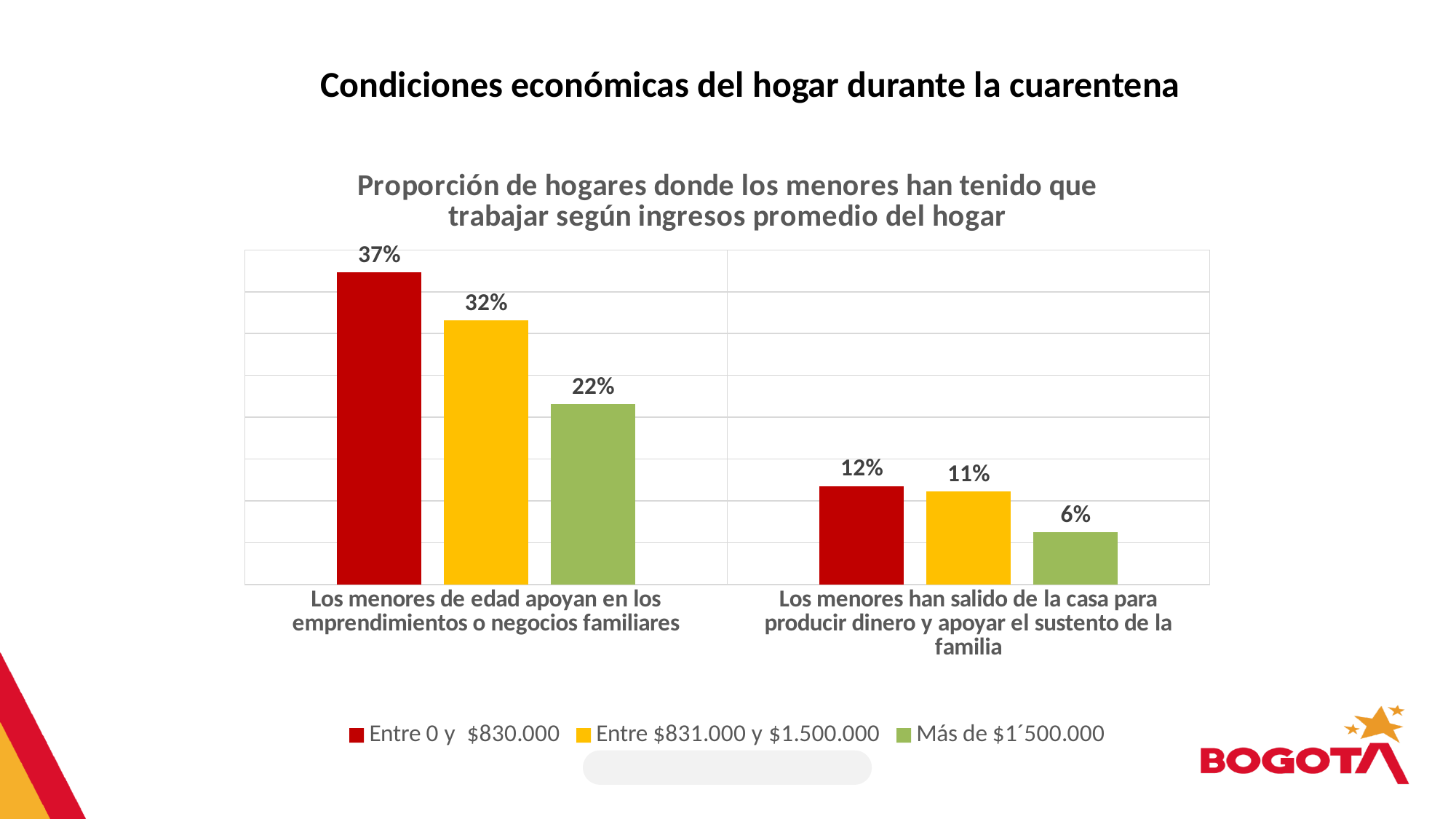
What is the value for 'Entre 0 y $830.000' in the category 'Los menores de edad apoyan en los emprendimientos o negocios familiares'? 37% What is the value for 'Más de $1´500.000' in the category 'Los menores han salido de la casa para producir dinero y apoyar el sustento de la familia'? 6% What is the difference between the 'Entre 0 y $830.000' and 'Más de $1´500.000' values in the category 'Los menores de edad apoyan en los emprendimientos o negocios familiares'? 15% How many series does the legend list? 3 Which income group has the highest value in the category 'Los menores de edad apoyan en los emprendimientos o negocios familiares'? Entre 0 y $830.000 What is the difference between the 'Entre $831.000 y $1.500.000' and 'Más de $1´500.000' values in the category 'Los menores han salido de la casa para producir dinero y apoyar el sustento de la familia'? 5% What kind of chart is shown on the slide? Bar chart What is the title of the chart? Proporción de hogares donde los menores han tenido que trabajar según ingresos promedio del hogar What is the value for 'Entre $831.000 y $1.500.000' in the category 'Los menores de edad apoyan en los emprendimientos o negocios familiares'? 32% Which is larger: the 'Entre $831.000 y $1.500.000' value for 'Los menores de edad apoyan en los emprendimientos o negocios familiares' or the 'Entre 0 y $830.000' value for 'Los menores han salido de la casa para producir dinero y apoyar el sustento de la familia'? Entre $831.000 y $1.500.000 for 'Los menores de edad apoyan en los emprendimientos o negocios familiares' Which income group has the lowest value in the category 'Los menores han salido de la casa para producir dinero y apoyar el sustento de la familia'? Más de $1´500.000 What is the value for 'Entre 0 y $830.000' in the category 'Los menores han salido de la casa para producir dinero y apoyar el sustento de la familia'? 12%